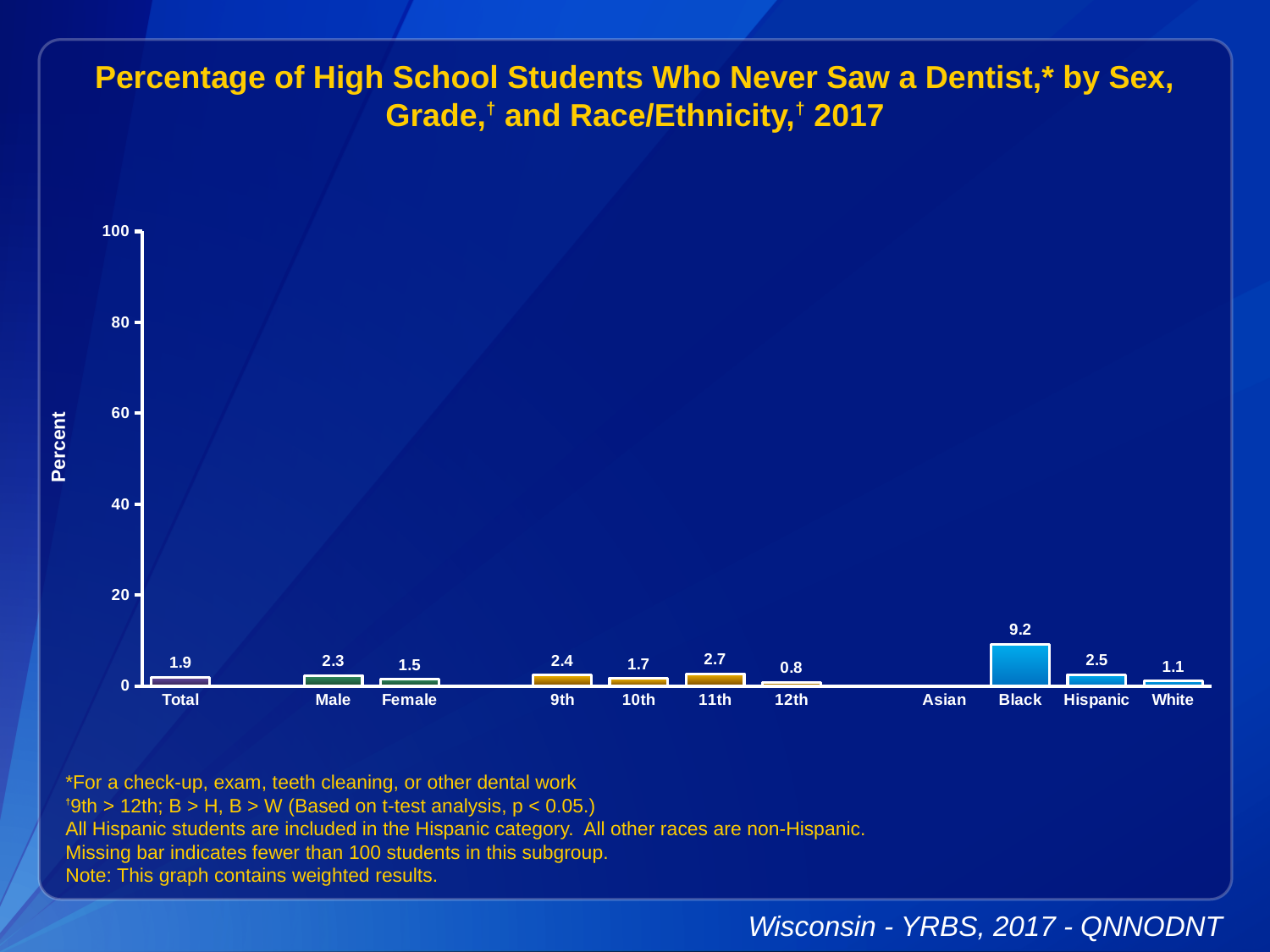
Which is larger, the value for 9th or the value for 10th? 9th Which category has the lowest value among those with a bar shown? 12th What is the value for Male? 2.3 What is the value for 12th? 0.8 What is the value for Black? 9.2 Which category has the highest value? Black Which category has no bar shown? Asian Is the value for Black greater or less than 20? less What is the difference between the values for Male and Female? 0.8 What is the difference between the values for Black and White? 8.1 What is the value for Total? 1.9 What kind of chart is shown on the slide? bar chart